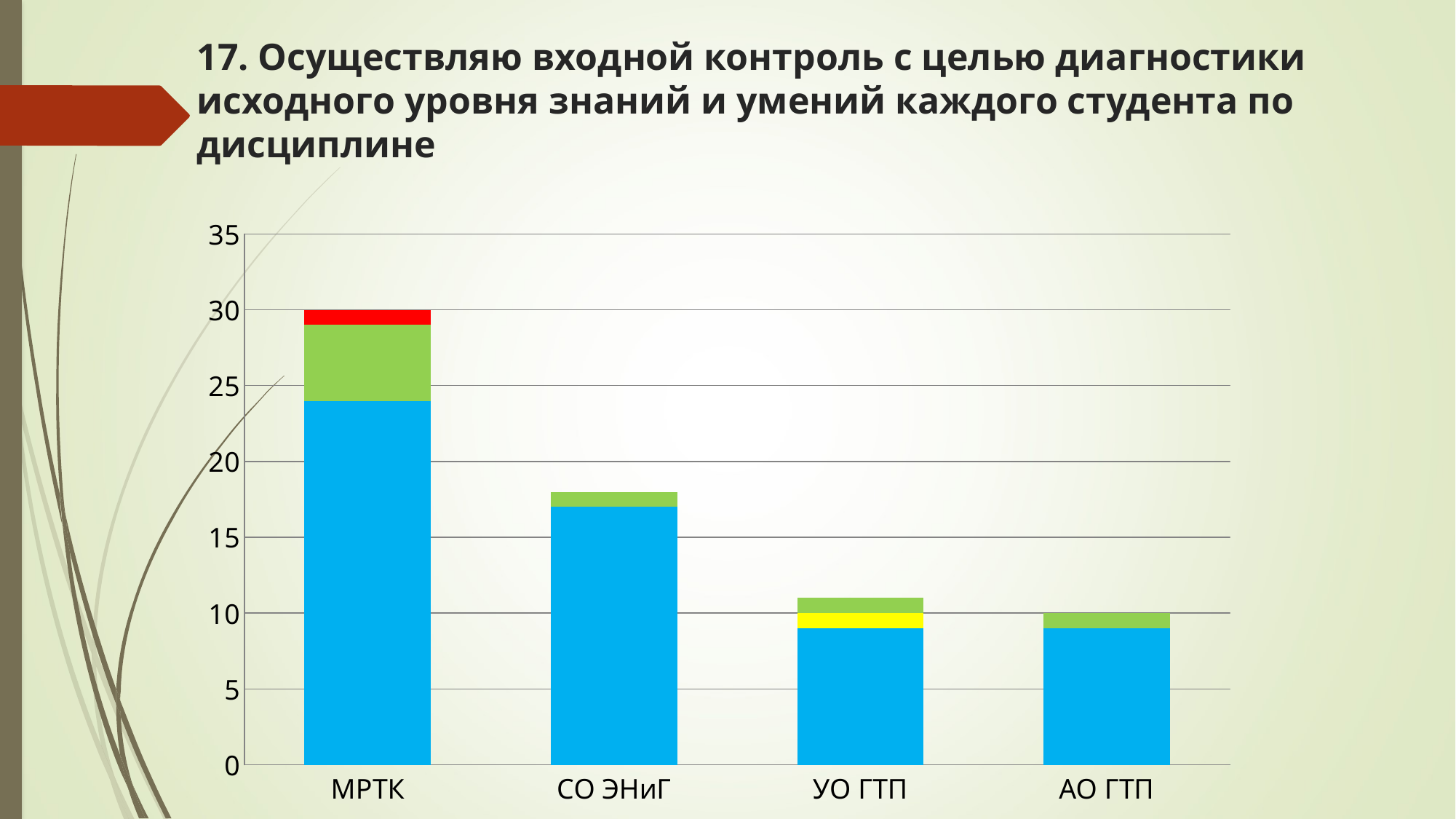
Which category has the shortest bar? АО ГТП How many categories are shown on the x axis? 4 Is the total for СО ЭНиГ greater or less than 20? less Is the total for СО ЭНиГ greater or less than 15? greater Which category has the tallest bar? МРТК Is the total for МРТК greater or less than 25? greater Which category's bar includes a yellow segment? УО ГТП What kind of chart is shown on the slide? bar chart Do the bar totals rise or fall from left to right along the x axis? fall Which bar is taller, МРТК or СО ЭНиГ? МРТК Which category's bar includes a red segment? МРТК